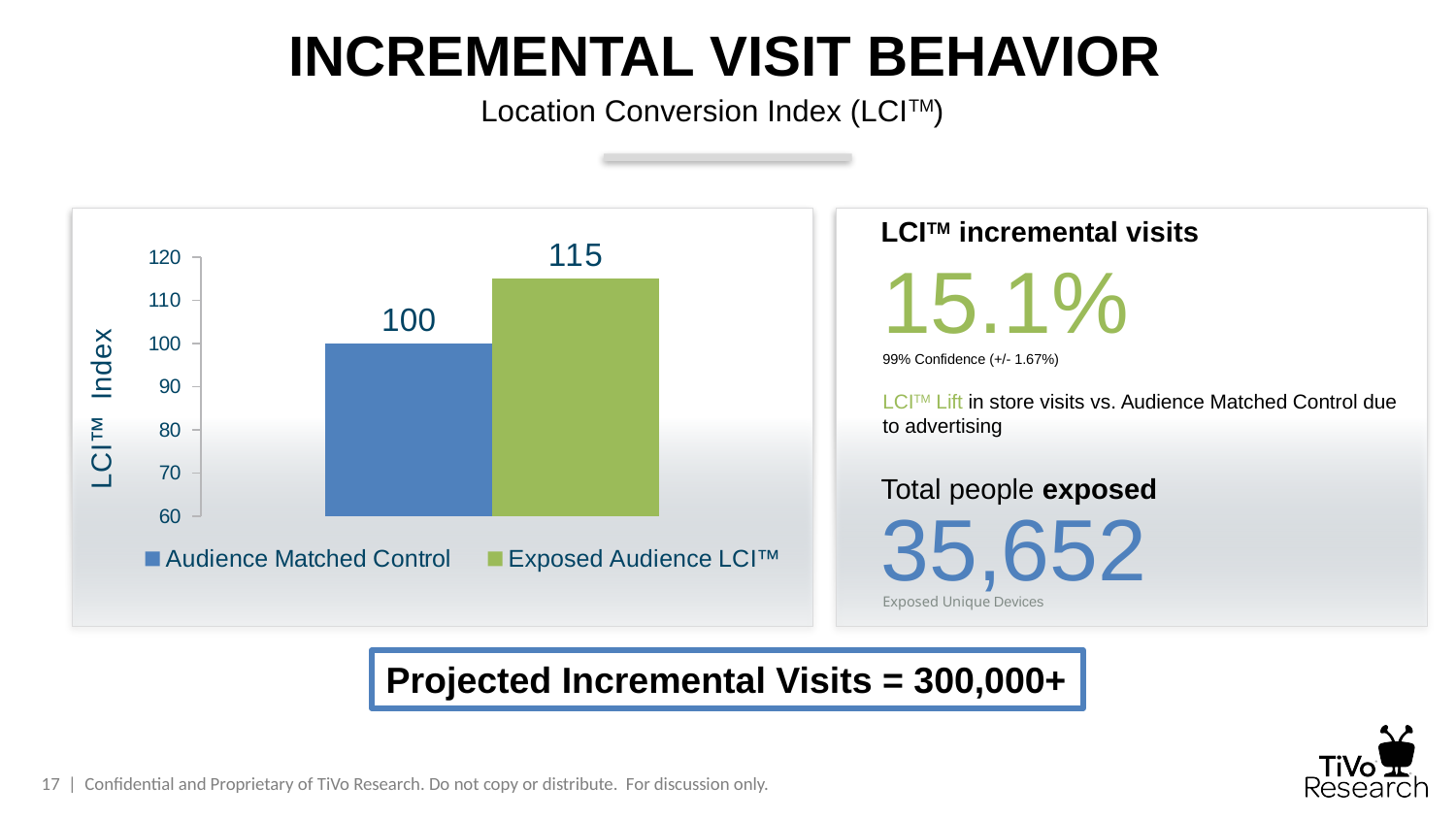
What is the difference between the Exposed Audience LCI™ value and the Audience Matched Control value? 15 How many series does the legend list? 2 Is the value for Exposed Audience LCI™ greater or less than 110? greater What colour is the bar for Exposed Audience LCI™? green What is the LCI Index value for Audience Matched Control? 100 Which series has the higher LCI Index value? Exposed Audience LCI™ Is the value for Exposed Audience LCI™ larger or smaller than the value for Audience Matched Control? larger Which series has the lower LCI Index value? Audience Matched Control What is the label on the vertical axis of the chart? LCI™ Index What is the LCI Index value for Exposed Audience LCI™? 115 How many bars are plotted in the chart? 2 What kind of chart is shown on the slide? bar chart